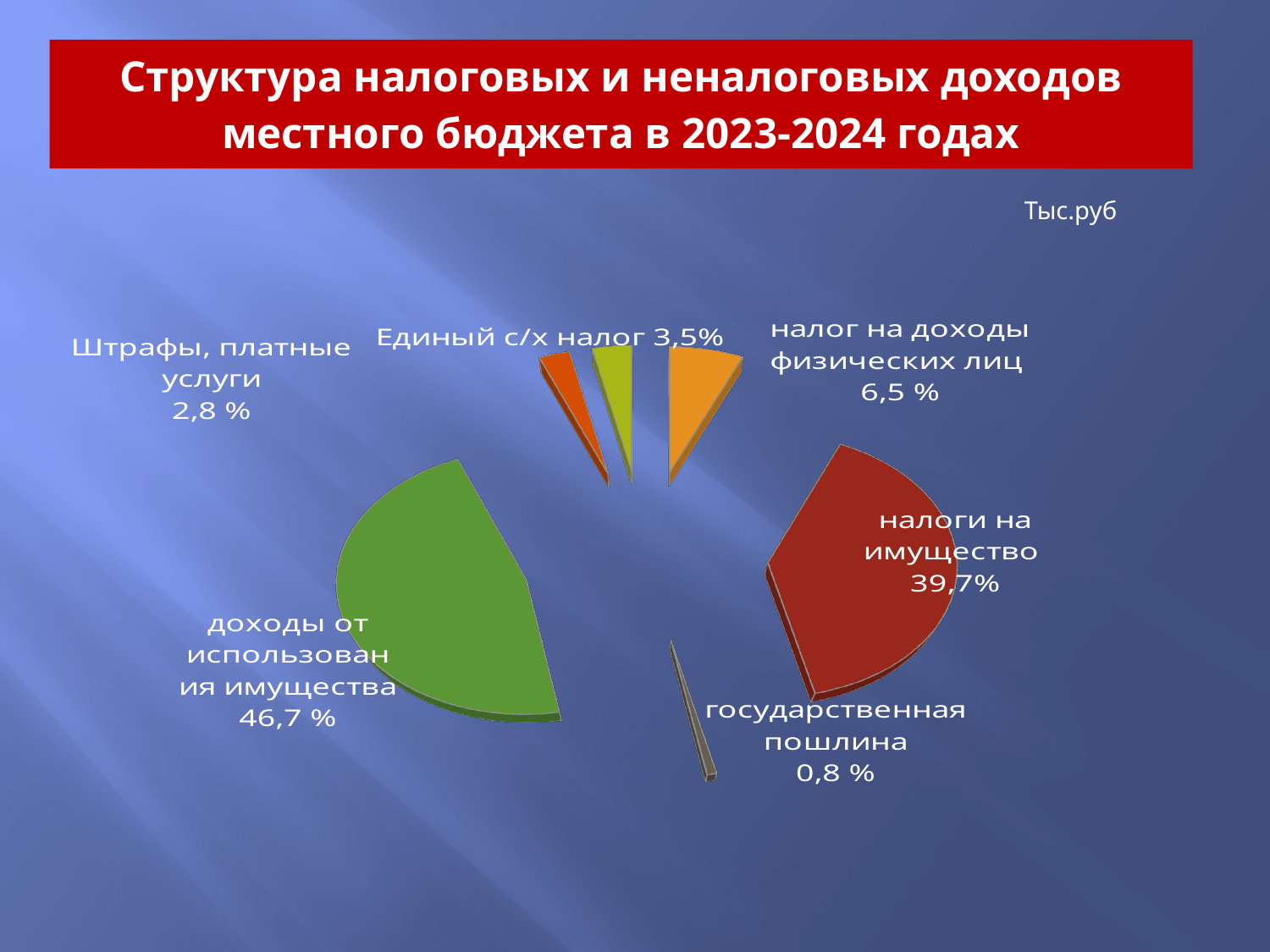
Which category has the smallest slice of the pie? государственная пошлина What share of the pie does «доходы от использования имущества» have? 46,7 % By how many percentage points does «доходы от использования имущества» exceed «налоги на имущество»? 7 % What share is shown for «государственная пошлина»? 0,8 % What type of chart is shown on the slide? Pie chart What share is shown for «Единый с/х налог»? 3,5% How many categories (slices) does the pie chart show? 6 Which is larger: the share of «Единый с/х налог» or the share of «Штрафы, платные услуги»? Единый с/х налог What share is shown for «налоги на имущество»? 39,7% What share is shown for «налог на доходы физических лиц»? 6,5 % Which category has the largest slice of the pie? доходы от использования имущества What is the difference between the shares of «налог на доходы физических лиц» and «Единый с/х налог»? 3 %